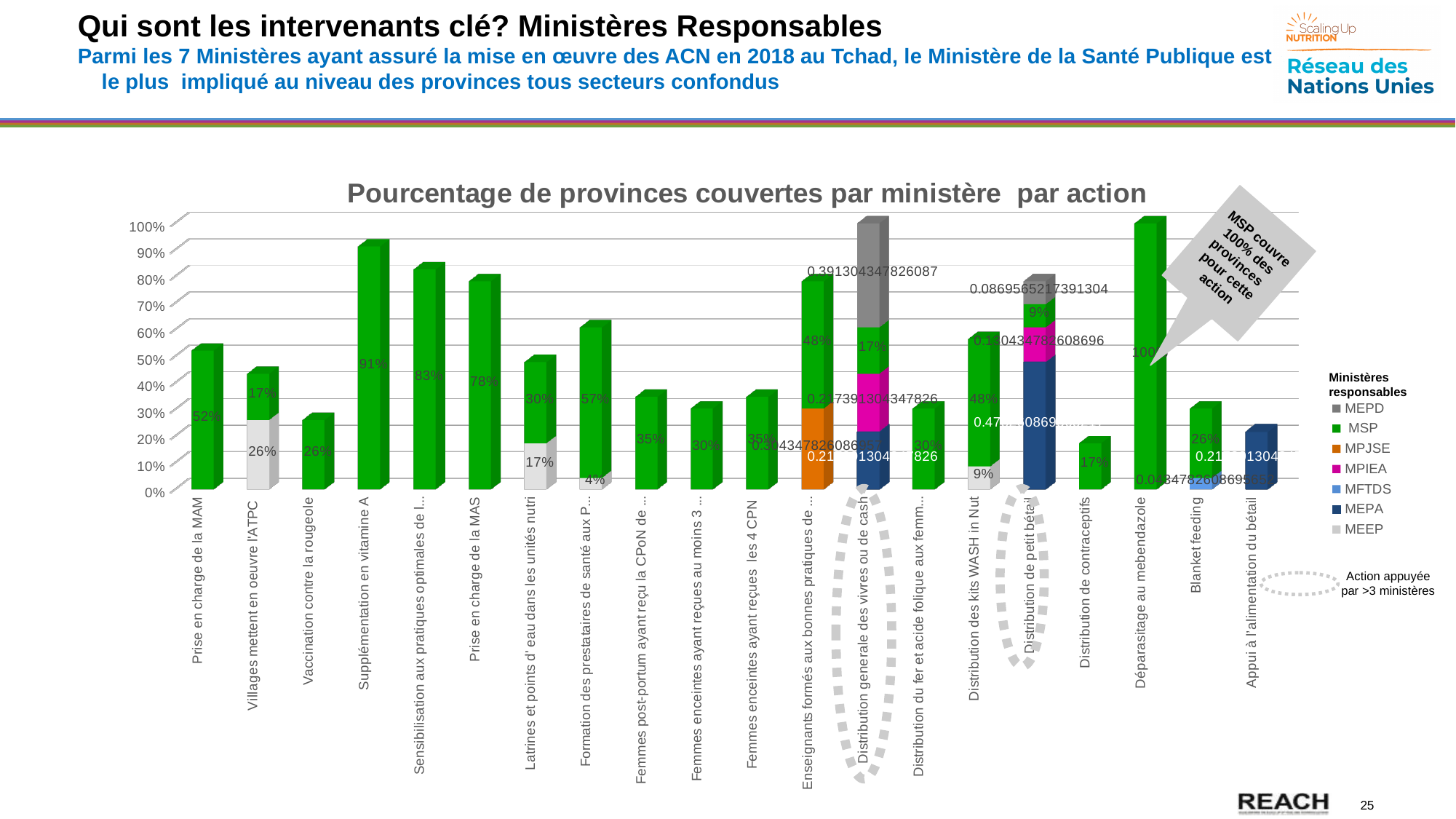
What is the MSP value for Distribution de contraceptifs? 17% What is the total of the stacked bar for Latrines et points d'eau dans les unités nutri (MSP plus MEEP)? 47% What is the MSP value for Prise en charge de la MAS? 78% What kind of chart is shown on the slide? Stacked bar chart How many ministries (series) does the legend list? 7 What is the difference between the MSP values for Supplémentation en vitamine A and Prise en charge de la MAS? 13 percentage points Which action has the highest MSP value? Déparasitage au mebendazole What is the MEEP value for Villages mettent en oeuvre l'ATPC? 26% What is the MSP value for Supplémentation en vitamine A? 91% How many actions (categories) are shown on the x axis? 20 What is the title of the chart? Pourcentage de provinces couvertes par ministère par action Which has the larger MSP value: Prise en charge de la MAM or Formation des prestataires de santé? Formation des prestataires de santé